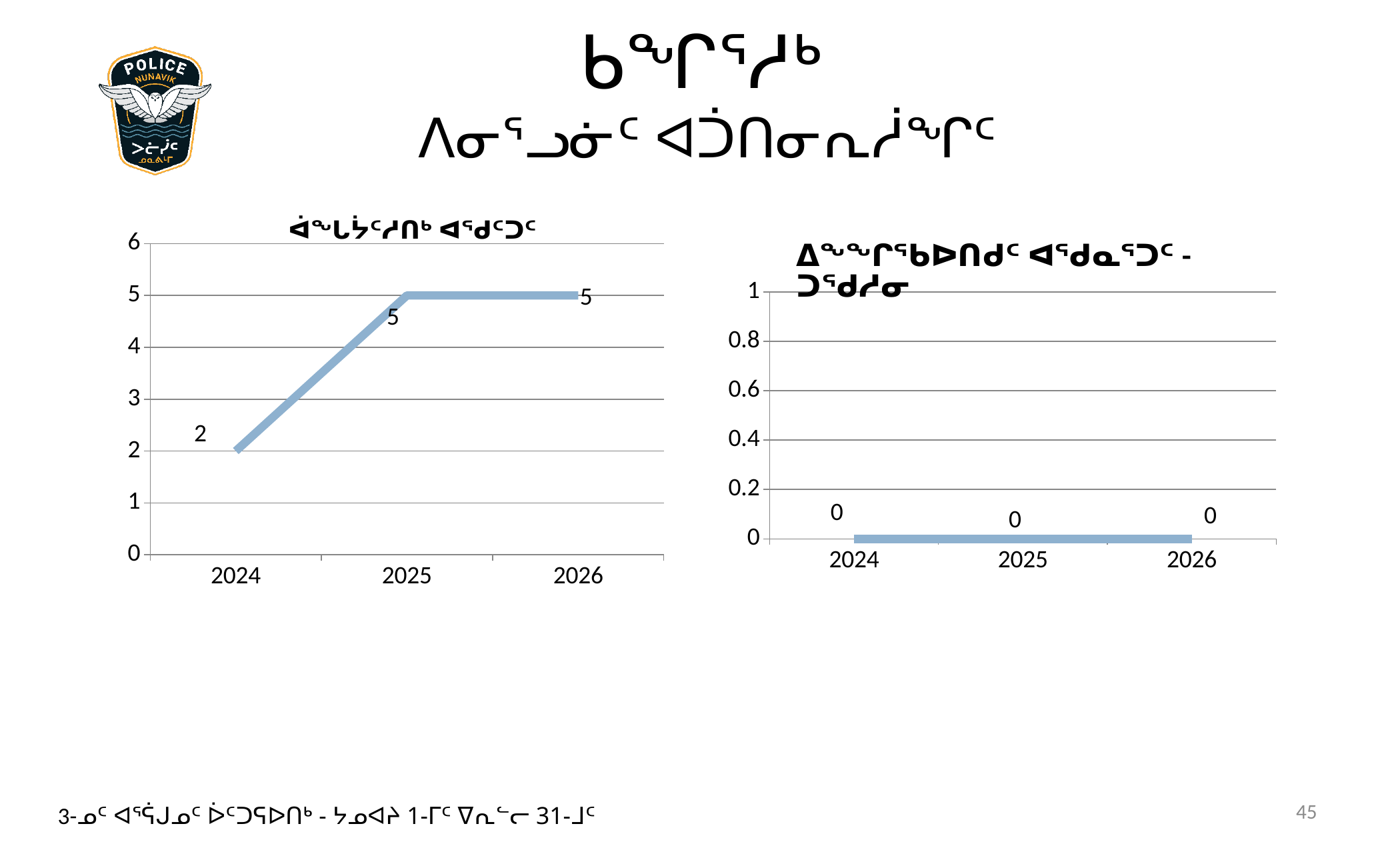
What kind of chart is the left chart? line chart In the right chart, what is the highest value shown on the y axis? 1 In the right chart, what is the value for 2025? 0 In the left chart, what is the value for 2025? 5 In the left chart, what is the difference between the values for 2025 and 2024? 3 In the left chart, which year has the lowest value? 2024 In the left chart, is the value for 2024 greater or less than 3? less In the left chart, what is the value for 2024? 2 In the left chart, what is the value for 2026? 5 In the left chart, how many years are plotted on the x axis? 3 In the left chart, which is larger, the value for 2024 or the value for 2025? 2025 In the left chart, do the values rise or fall from 2024 to 2025? rise